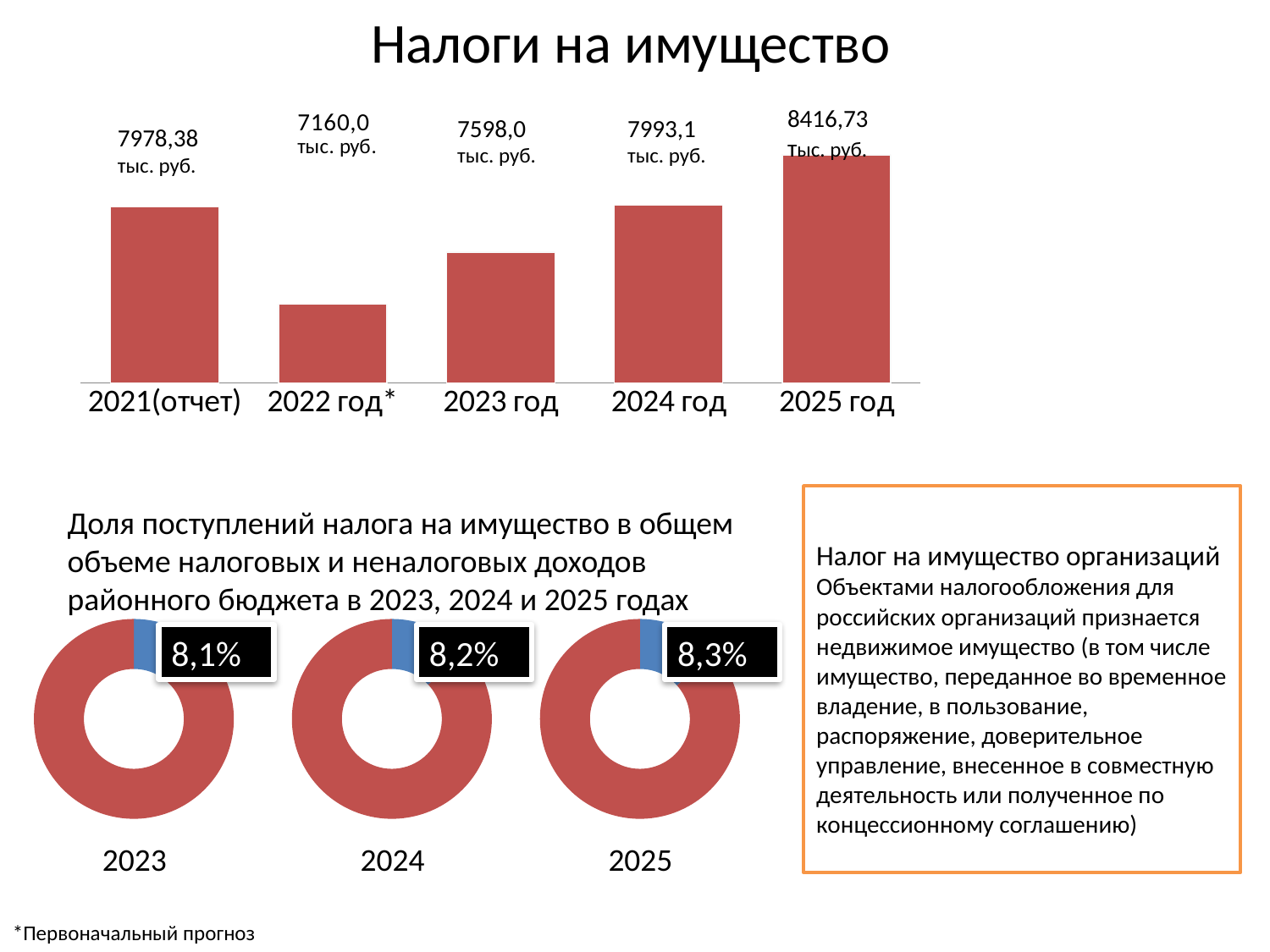
In the bar chart 'Налоги на имущество', which is larger: the value for 2021(отчет) or the value for 2024 год? 2024 год What type of chart is used at the top of the slide under the title 'Налоги на имущество'? bar chart In the bar chart 'Налоги на имущество', which year has the lowest value? 2022 год* How many bars are in the bar chart 'Налоги на имущество'? 5 In the donut chart for 2024 at the bottom of the slide, what share is shown for the property tax receipts? 8,2% In the bar chart 'Налоги на имущество', what is the difference between the values for 2025 год and 2021(отчет)? 438,35 тыс. руб. In the bar chart 'Налоги на имущество', what is the value for 2025 год? 8416,73 тыс. руб. In the bar chart 'Налоги на имущество', do the values rise or fall from 2022 год* to 2025 год? rise In the bar chart 'Налоги на имущество', what is the value for 2021(отчет)? 7978,38 тыс. руб. In the bar chart 'Налоги на имущество', what is the value for 2022 год*? 7160,0 тыс. руб. In the bar chart 'Налоги на имущество', what is the difference between the values for 2024 год and 2023 год? 395,1 тыс. руб. In the bar chart 'Налоги на имущество', which year has the highest value? 2025 год